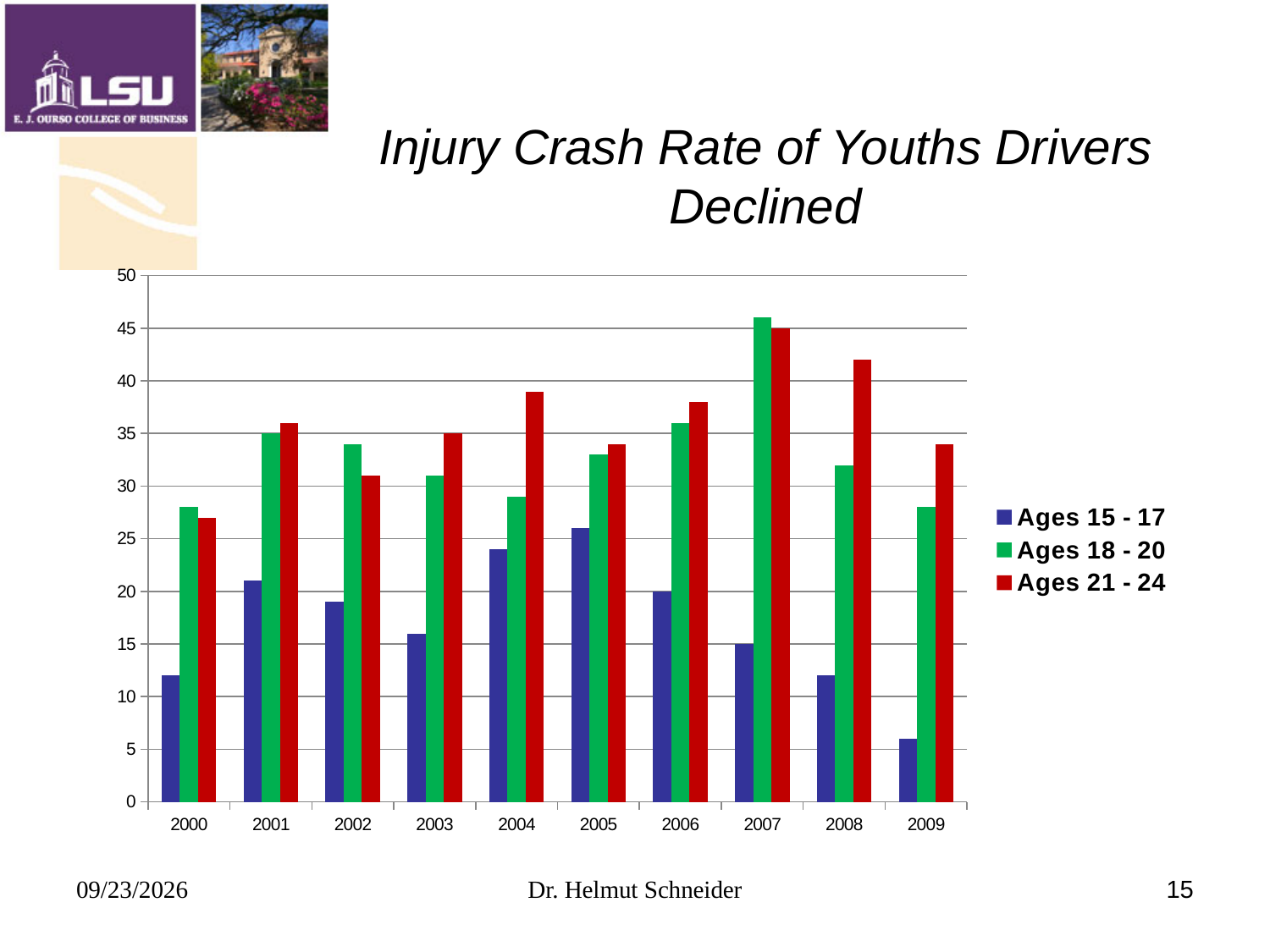
Which age group is shown in red in the legend? Ages 21 - 24 What is the title of the chart? Injury Crash Rate of Youths Drivers Declined In which year is the value for Ages 18 - 20 highest? 2007 What kind of chart is shown on the slide? bar chart How many series does the legend list? 3 Is the value for Ages 15 - 17 in 2009 greater or less than 10? less In 2009, which is larger: the value for Ages 18 - 20 or the value for Ages 21 - 24? Ages 21 - 24 Does the value for Ages 15 - 17 rise or fall from 2005 to 2009? fall Is the value for Ages 21 - 24 in 2008 greater or less than 40? greater How many years are shown on the x axis? 10 In which year is the value for Ages 15 - 17 lowest? 2009